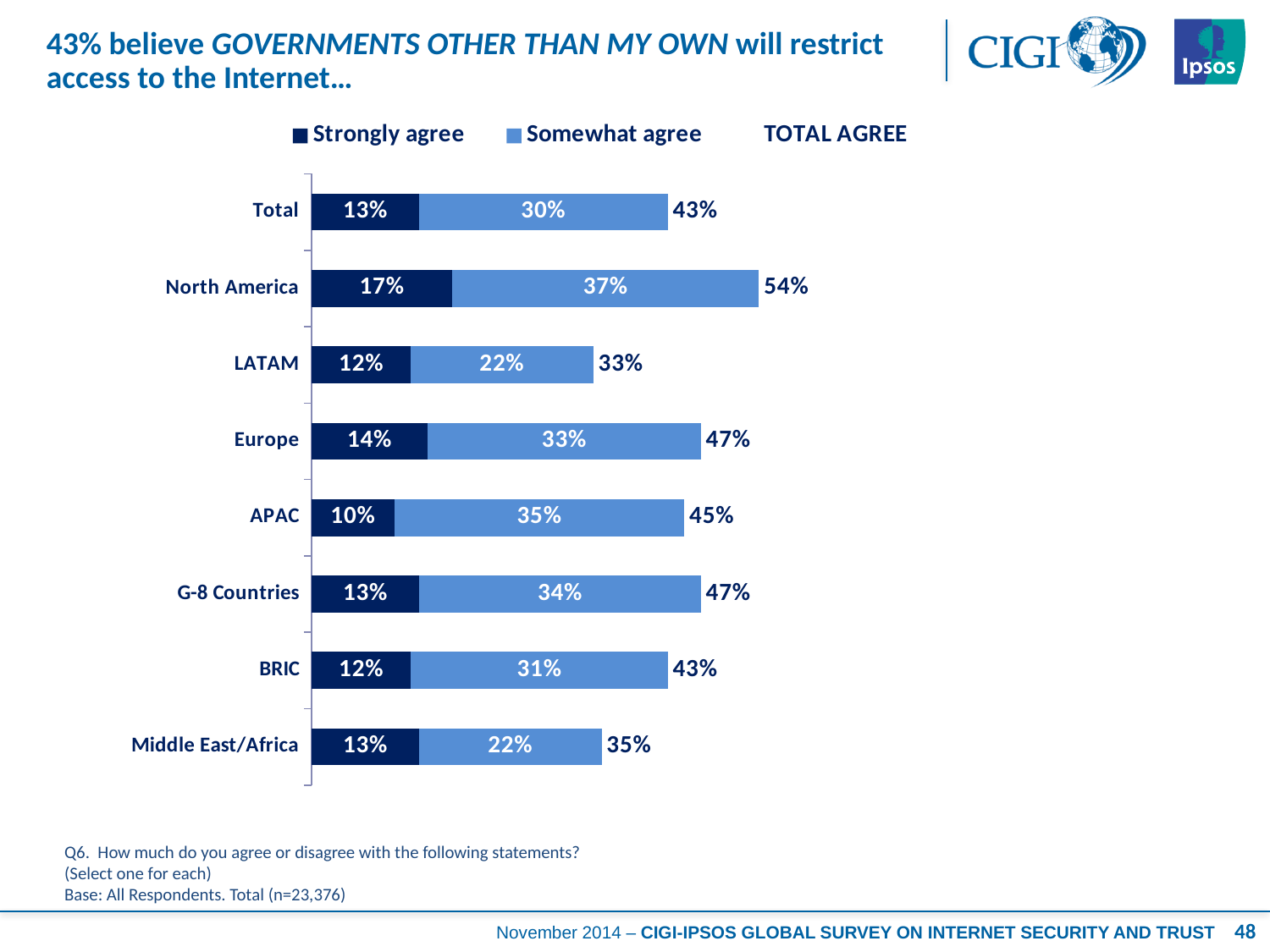
How many series does the legend list? 3 Which region has the highest TOTAL AGREE value? North America What is the total of the stacked bar for G-8 Countries? 47% What kind of chart is shown on the slide? Stacked bar chart What is the difference between the TOTAL AGREE values for North America and Middle East/Africa? 19% Which region has the lowest 'Strongly agree' value? APAC How many categories are shown on the chart? 8 What is the TOTAL AGREE value for LATAM? 33% What is the 'Somewhat agree' value for APAC? 35% Which series is shown in dark navy blue? Strongly agree What is the 'Strongly agree' value for North America? 17% Which is larger, the 'Somewhat agree' value for Europe or for BRIC? Europe